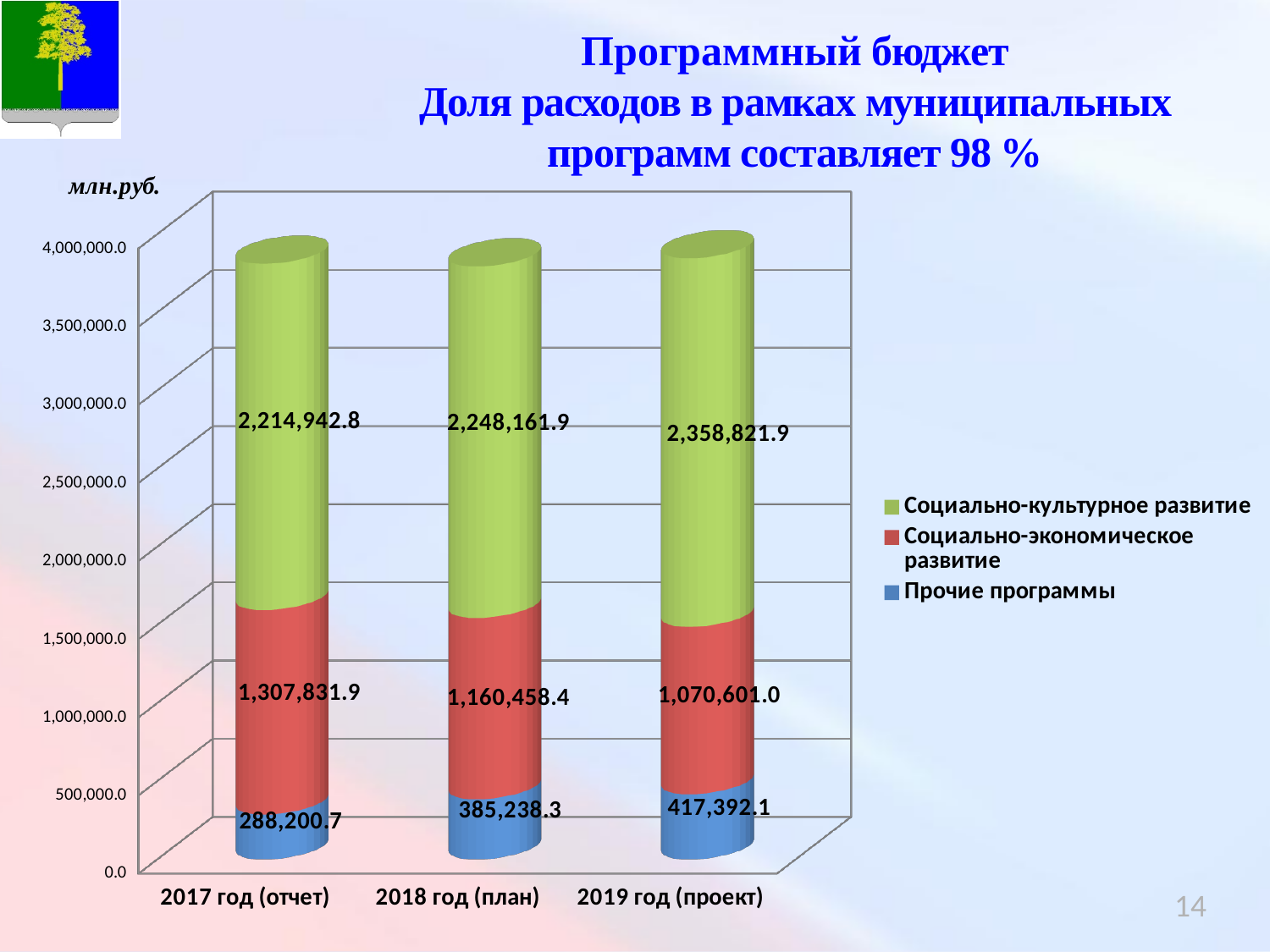
How many year categories are shown on the x axis? 3 What is the total of the stacked bar for 2019 год (проект)? 3,846,815.0 Which is larger: Социально-экономическое развитие in 2017 год (отчет) or in 2019 год (проект)? 2017 год (отчет) What is the value for Прочие программы in 2017 год (отчет)? 288,200.7 How many series does the legend list? 3 What is the value for Социально-экономическое развитие in 2018 год (план)? 1,160,458.4 In which year is the value for Социально-экономическое развитие the lowest? 2019 год (проект) Does the value for Социально-экономическое развитие rise or fall from 2017 to 2019? Fall What is the difference between the Социально-культурное развитие values for 2019 год (проект) and 2017 год (отчет)? 143,879.1 In which year is the value for Прочие программы the highest? 2019 год (проект) What type of chart is shown on the slide? Stacked bar chart What is the value for Социально-культурное развитие in 2019 год (проект)? 2,358,821.9